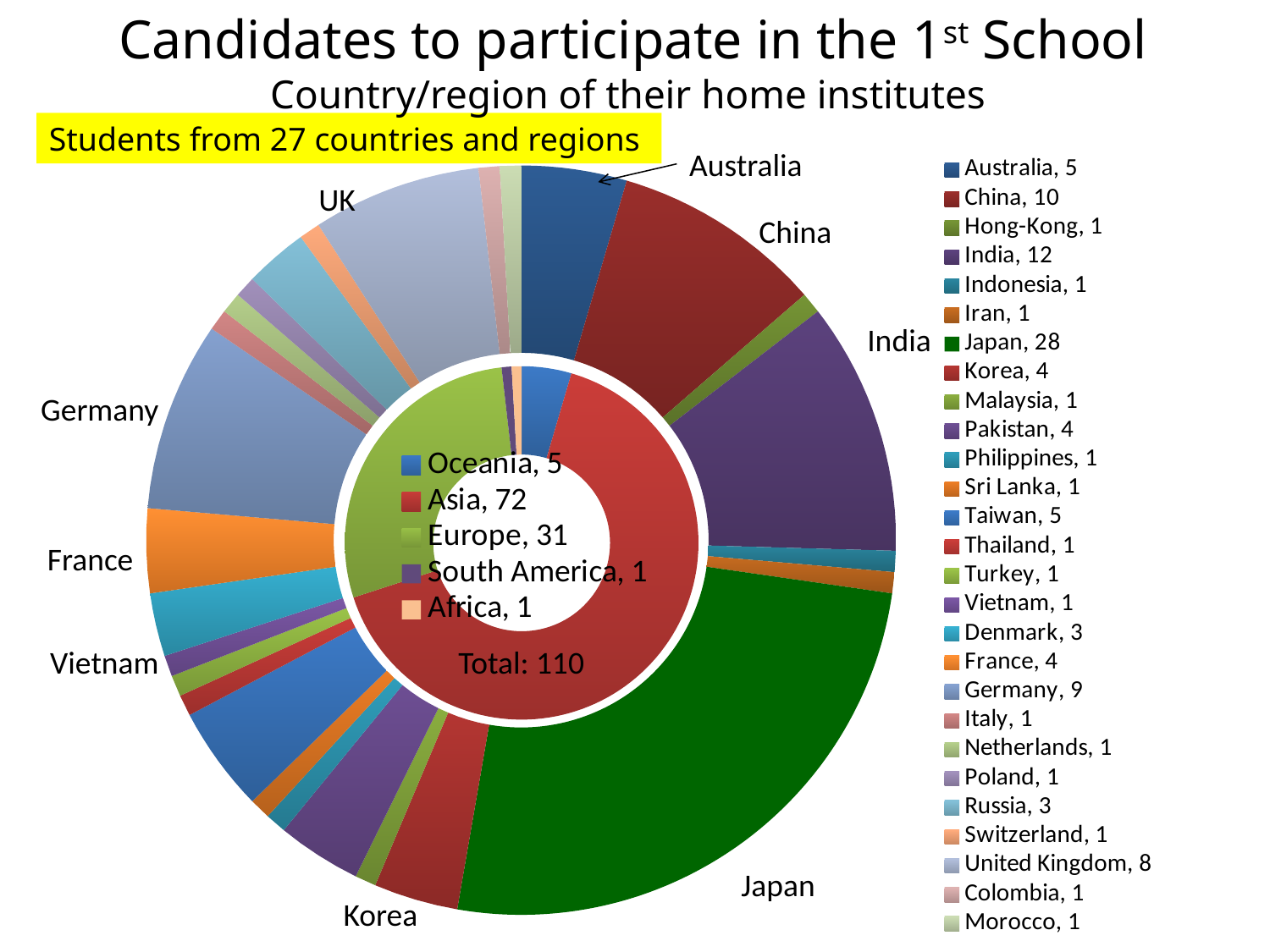
What is the difference between the number of candidates from India and from China? 2 What kind of chart is shown on the slide? doughnut chart How many candidates are from Asia according to the inner ring? 72 Which country has the highest number of candidates? Japan How many candidates come from Japan? 28 How many candidates come from the United Kingdom? 8 What is the difference between the number of candidates from Asia and from Europe? 41 How many countries/regions are listed in the legend? 27 Which has more candidates, Germany or France? Germany How many candidates come from Germany? 9 What is the total number of candidates shown on the chart? 110 Which continent/region has the lowest number of candidates in the inner ring? South America and Africa (1 each)